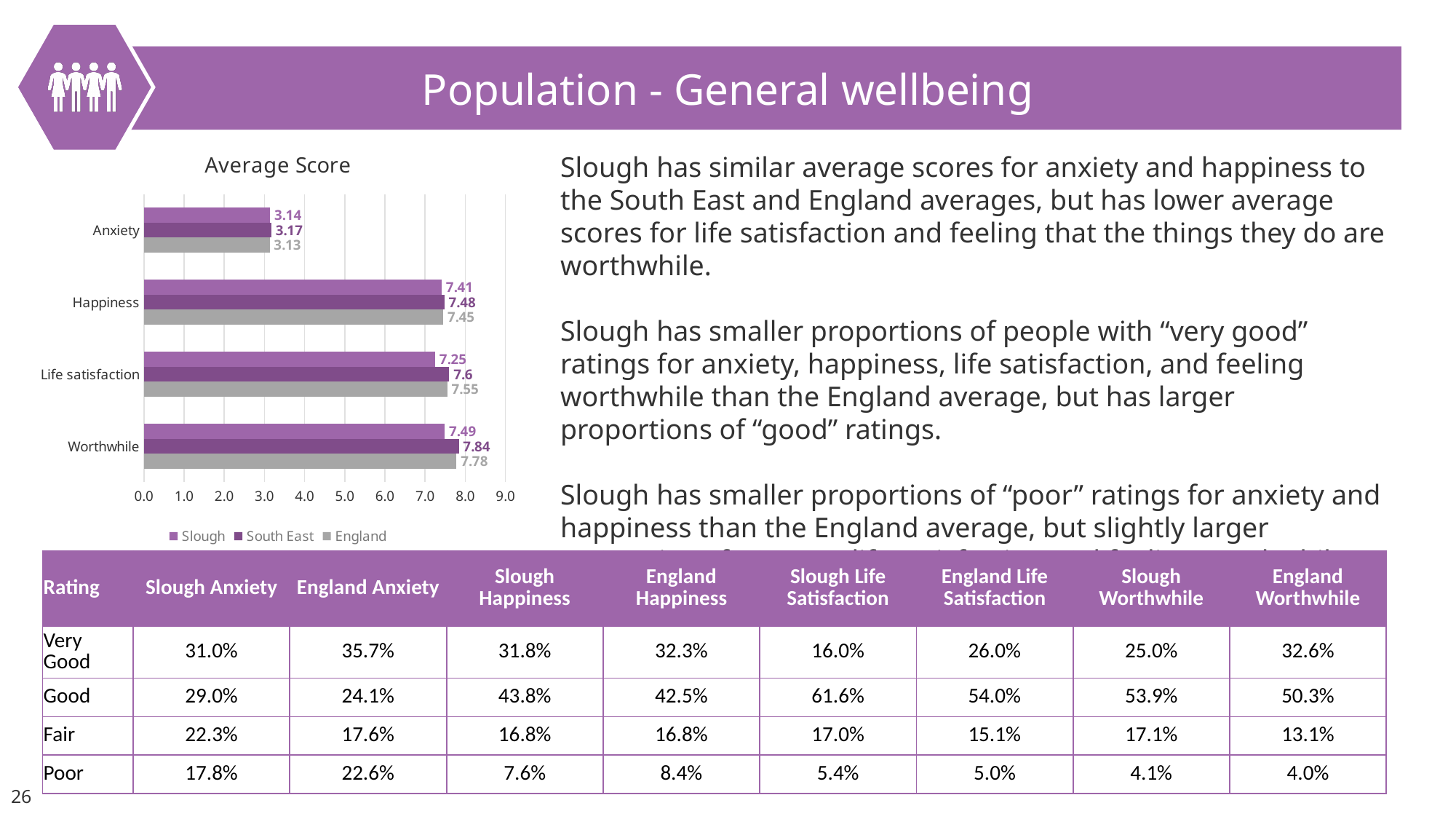
In the Average Score chart, which is larger for Life satisfaction: the Slough score or the South East score? South East What is the England average score for Life satisfaction in the Average Score chart? 7.55 In the Average Score chart, what is the difference between the England and Slough scores for Life satisfaction? 0.3 In the Average Score chart, which category has the highest South East score? Worthwhile In the Average Score chart, is the Slough score for Happiness greater or less than 7.0? greater What type of chart is the Average Score chart? Bar chart In the Average Score chart, what is the difference between the South East and Slough scores for Worthwhile? 0.35 In the Average Score chart, which category has the lowest Slough score? Anxiety What is the Slough average score for Anxiety in the Average Score chart? 3.14 How many categories are shown in the Average Score chart? 4 How many series does the legend of the Average Score chart list? 3 What is the South East average score for Worthwhile in the Average Score chart? 7.84